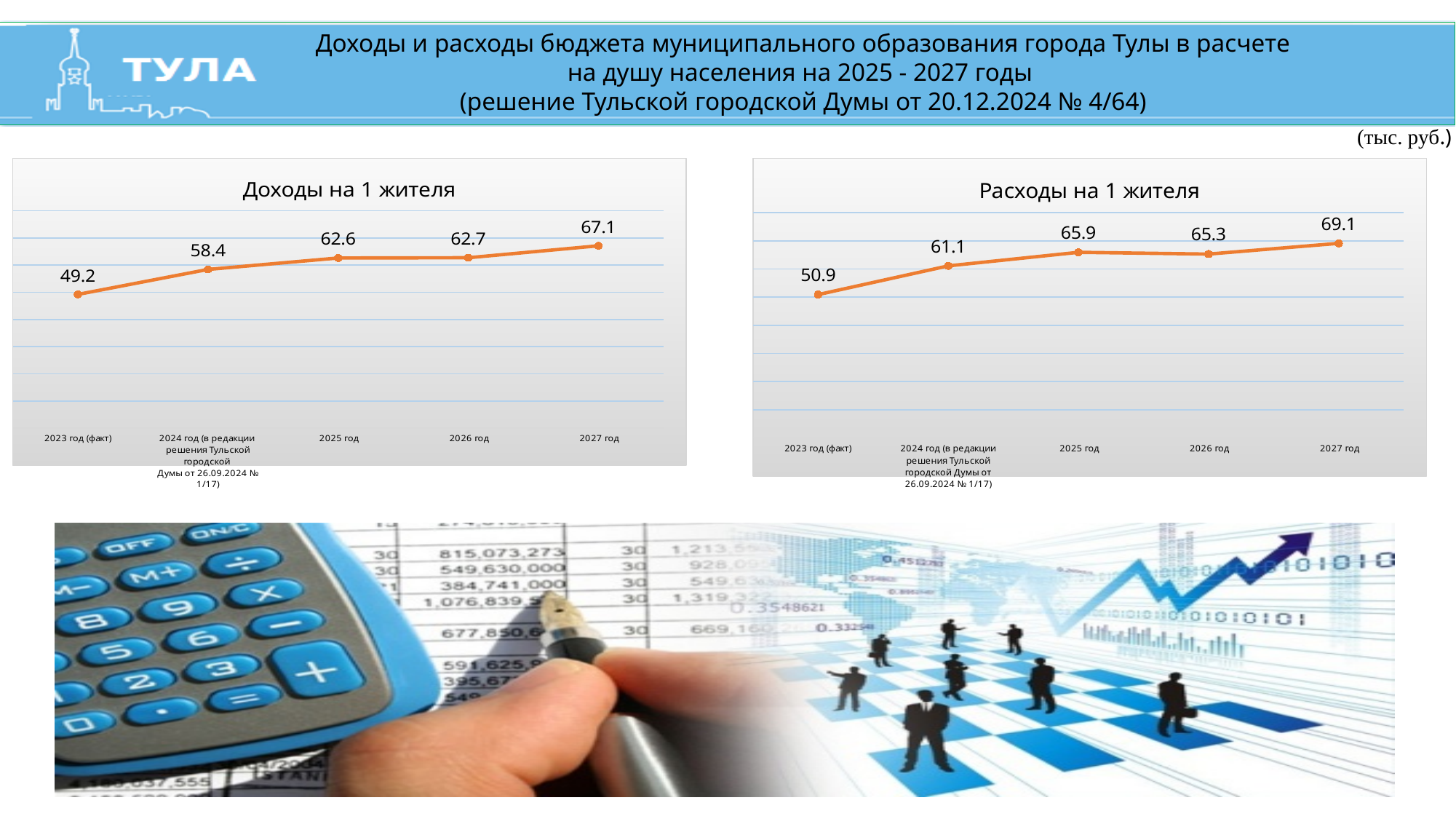
In the chart 'Доходы на 1 жителя', which year has the highest value? 2027 год In the chart 'Расходы на 1 жителя', what is the value for 2027 год? 69.1 In the chart 'Доходы на 1 жителя', what is the difference between the values for 2027 год and 2023 год (факт)? 17.9 In the chart 'Расходы на 1 жителя', which is larger: the value for 2024 год or the value for 2026 год? 2026 год What unit is stated for the values on the slide? тыс. руб. How many data points are plotted in the chart 'Доходы на 1 жителя'? 5 In the chart 'Расходы на 1 жителя', which year has the lowest value? 2023 год (факт) What kind of chart is 'Расходы на 1 жителя'? Line chart In the chart 'Доходы на 1 жителя', what is the value for 2025 год? 62.6 In the chart 'Расходы на 1 жителя', what is the value for 2023 год (факт)? 50.9 In the chart 'Доходы на 1 жителя', do the values generally rise or fall from 2023 to 2027? Rise In the chart 'Расходы на 1 жителя', what is the difference between the values for 2025 год and 2026 год? 0.6